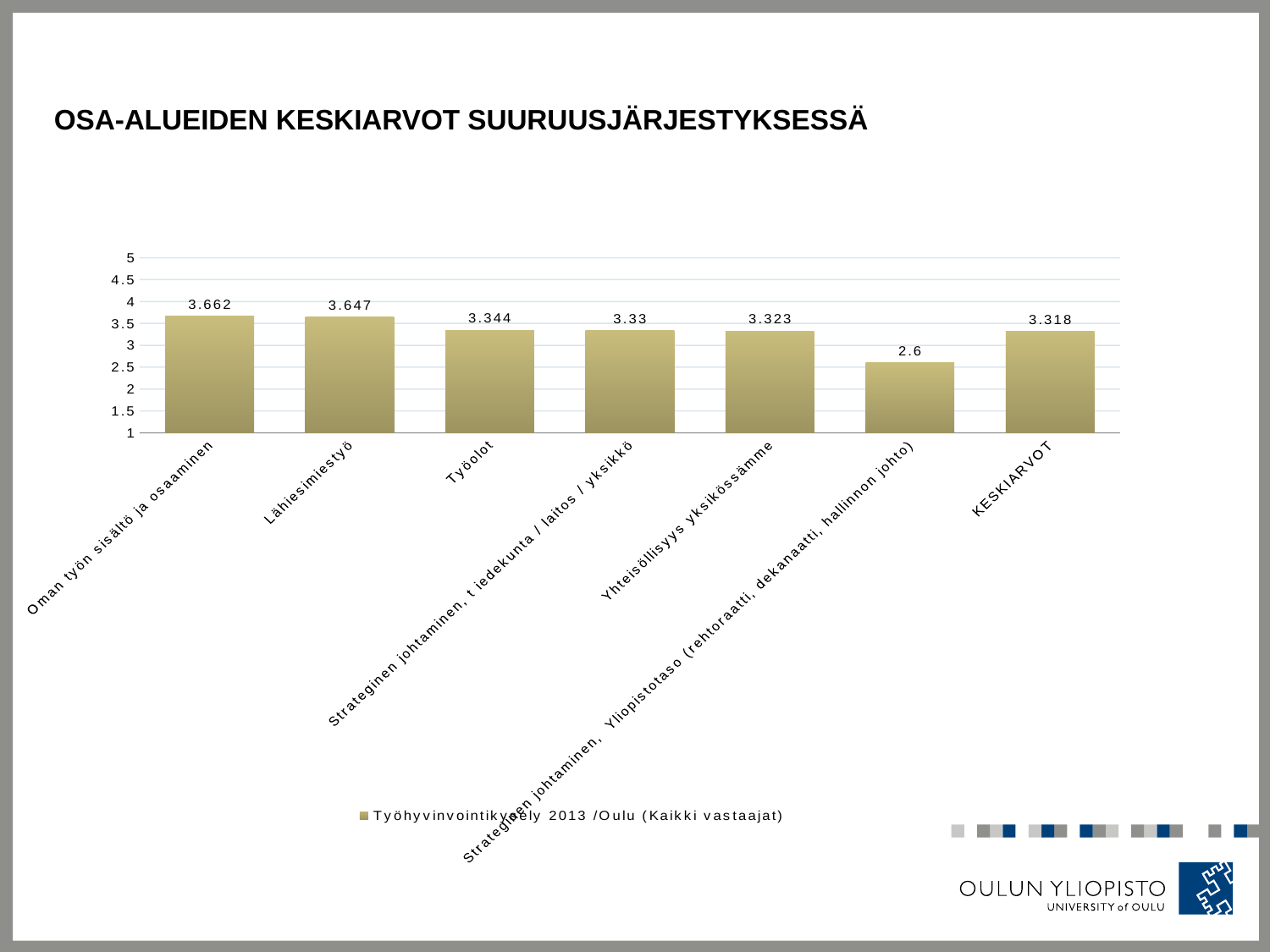
What is the value for Työolot? 3.344 What is the value for Lähiesimiestyö? 3.647 What is the difference between the values for Oman työn sisältö ja osaaminen and Työolot? 0.318 Which category has the highest value? Oman työn sisältö ja osaaminen What is the value for KESKIARVOT? 3.318 What is the legend entry of the chart? Työhyvinvointikysely 2013 /Oulu (Kaikki vastaajat) What kind of chart is shown on the slide? bar chart Which is larger, the value for Lähiesimiestyö or the value for Yhteisöllisyys yksikössämme? Lähiesimiestyö Which category has the lowest value? Strateginen johtaminen, Yliopistotaso (rehtoraatti, dekanaatti, hallinnon johto) What is the value for Yhteisöllisyys yksikössämme? 3.323 Is the value for Strateginen johtaminen, Yliopistotaso (rehtoraatti, dekanaatti, hallinnon johto) greater or less than 3? less How many categories are shown in the chart? 7